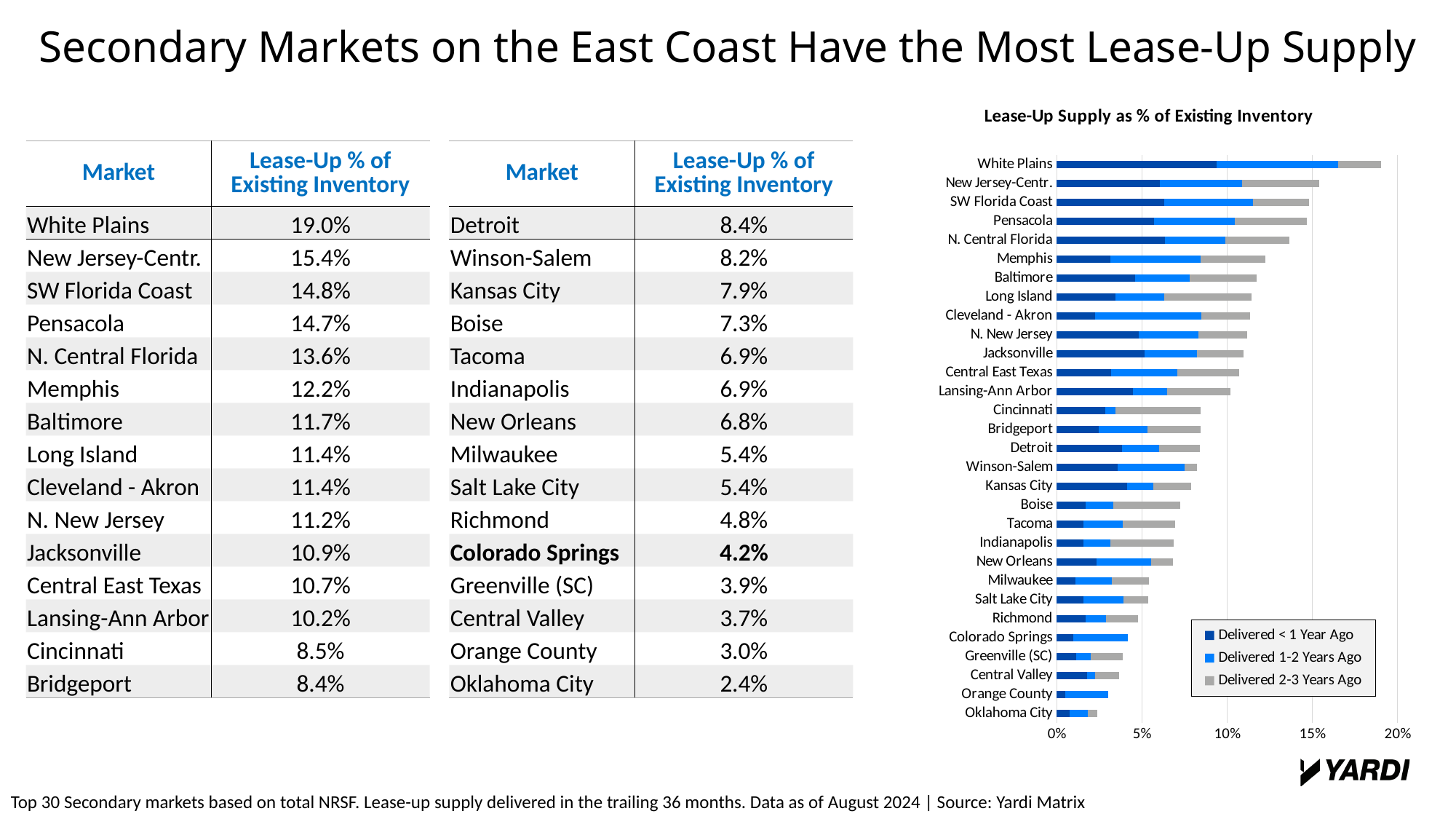
Do the total bar lengths rise or fall moving from the top of the chart to the bottom? Fall What is the difference between the total lease-up % for White Plains and Oklahoma City? 16.6% What is the total lease-up supply as % of existing inventory for Colorado Springs? 4.2% What kind of chart is shown on the slide? Stacked horizontal bar chart Which market has the lowest total lease-up supply as % of existing inventory? Oklahoma City Which has a larger total lease-up % of existing inventory, Memphis or Baltimore? Memphis How many series does the legend of the chart list? 3 What is the title of the chart? Lease-Up Supply as % of Existing Inventory Is the total lease-up supply for Pensacola greater or less than 10%? greater How many markets are plotted in the chart? 30 What is the total lease-up supply as % of existing inventory for White Plains? 19.0% Which market has the highest total lease-up supply as % of existing inventory? White Plains